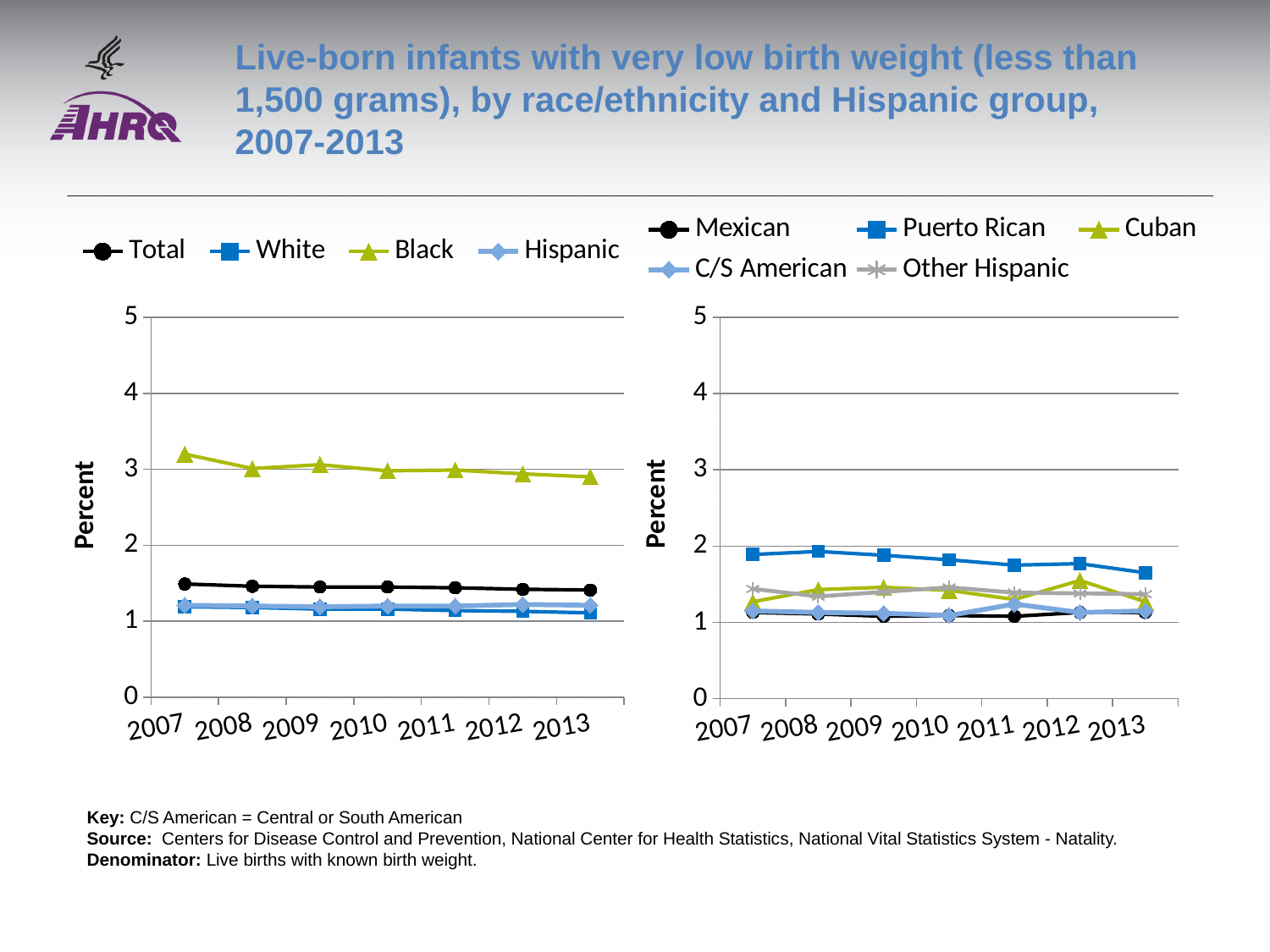
How many series does the legend of the left chart list? 4 In the left chart, is the value for Total in 2007 greater or less than 2? less In the right chart, does the Puerto Rican line rise or fall from 2007 to 2013? Fall In the right chart, which Hispanic group has the highest percentage across all years? Puerto Rican In the right chart, which is larger in 2010, the value for Puerto Rican or the value for Mexican? Puerto Rican In the left chart, what kind of chart is used to show the data? Line chart In the left chart, is the value for Black in 2007 greater or less than 3? greater How many series does the legend of the right chart list? 5 In the left chart, which group has the highest percentage of very low birth weight infants across all years? Black In the left chart, how many years are shown on the x axis? 7 In the right chart, is the value for Puerto Rican in 2007 greater or less than 2? less In the left chart, does the Black line rise or fall from 2007 to 2013? Fall